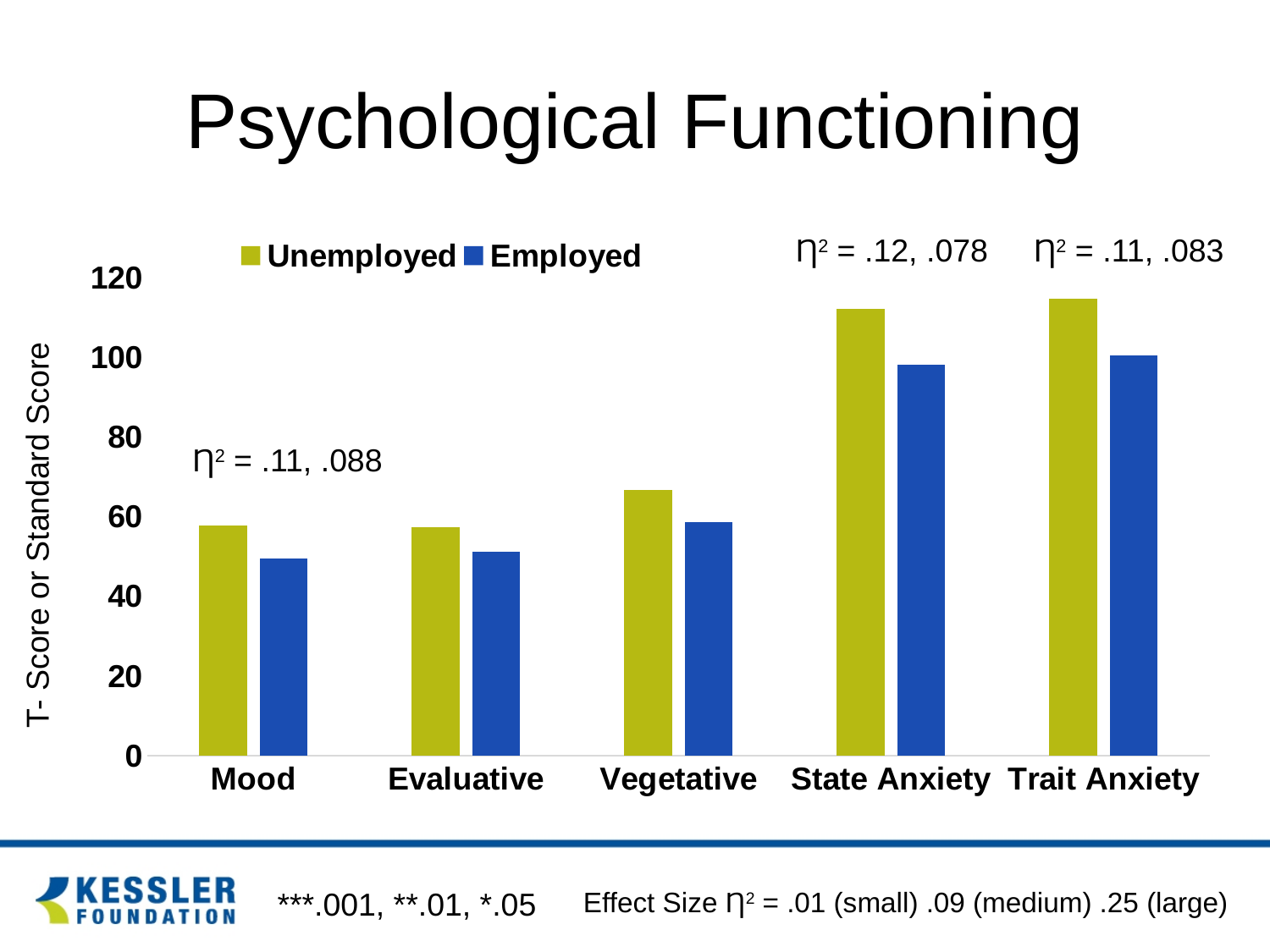
What kind of chart is shown on the slide? bar chart What is the title of the y axis of the chart? T- Score or Standard Score Is the Unemployed value for Trait Anxiety greater or less than 100? greater How many series does the chart's legend list? 2 How many categories are shown on the x axis of the chart? 5 For Mood, which series has the larger value, Unemployed or Employed? Unemployed Is the Employed value for Evaluative greater or less than 60? less Which two series are listed in the chart's legend? Unemployed and Employed Is the Unemployed value for State Anxiety greater or less than 100? greater Which is larger, the Unemployed value for State Anxiety or the Unemployed value for Vegetative? State Anxiety